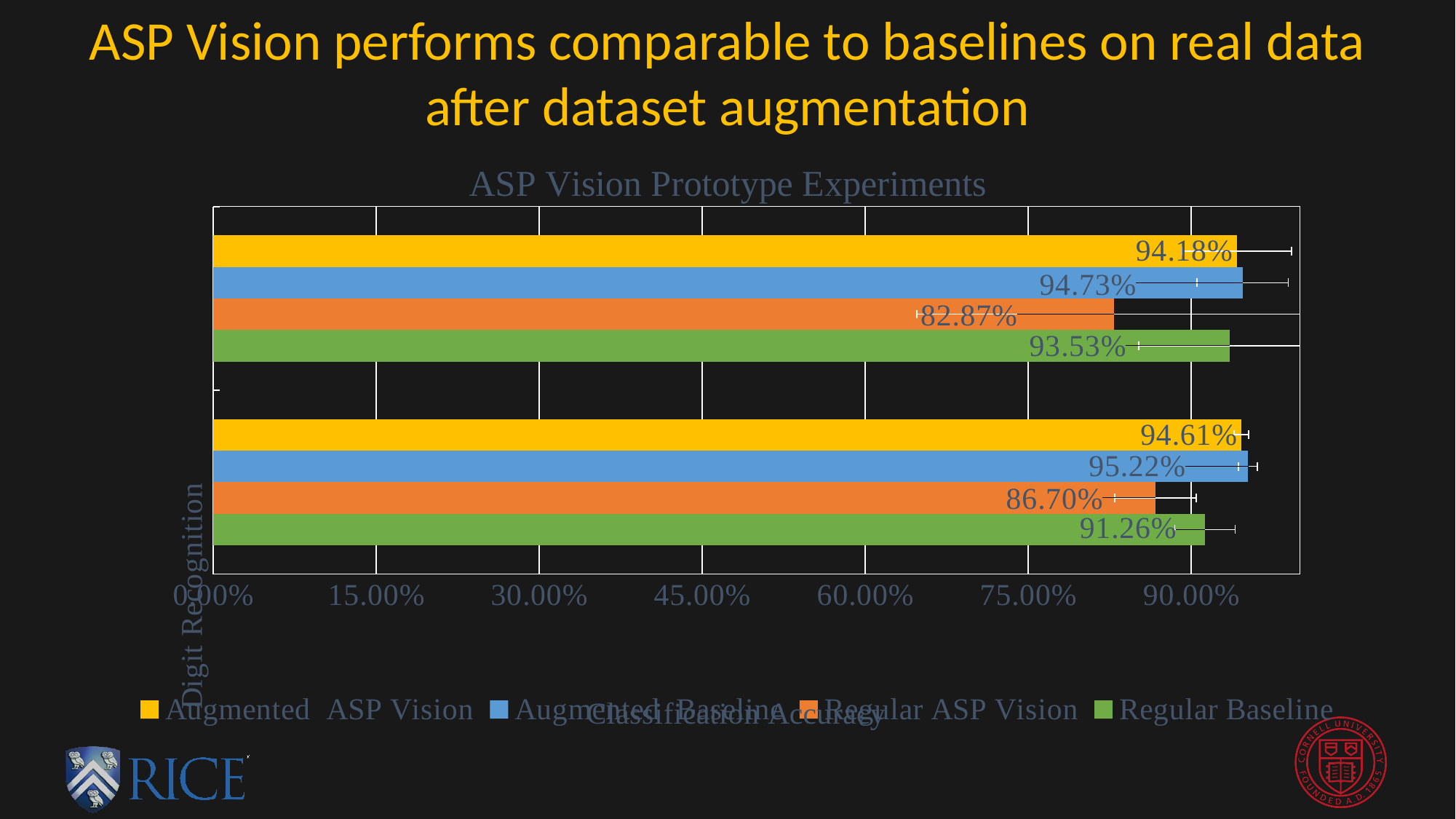
Is the value for Regular ASP Vision in the upper group of bars greater or less than 90.00%? less Is the value for Regular Baseline larger in the upper group of bars or the lower group of bars? upper group How many series does the legend of the chart list? 4 In the lower group of bars, what is the value for Augmented ASP Vision? 94.61% In the lower group of bars, what is the difference between Augmented Baseline and Regular ASP Vision? 8.52% What is the title of the chart? ASP Vision Prototype Experiments In the lower group of bars, what is the value for Augmented Baseline? 95.22% In the upper group of bars, which series has the lowest value? Regular ASP Vision In the lower group of bars, which series has the highest value? Augmented Baseline What kind of chart is shown on the slide? bar chart In the upper group of bars, what is the difference between Augmented Baseline and Augmented ASP Vision? 0.55% In the upper group of bars, what is the value for Regular ASP Vision? 82.87%